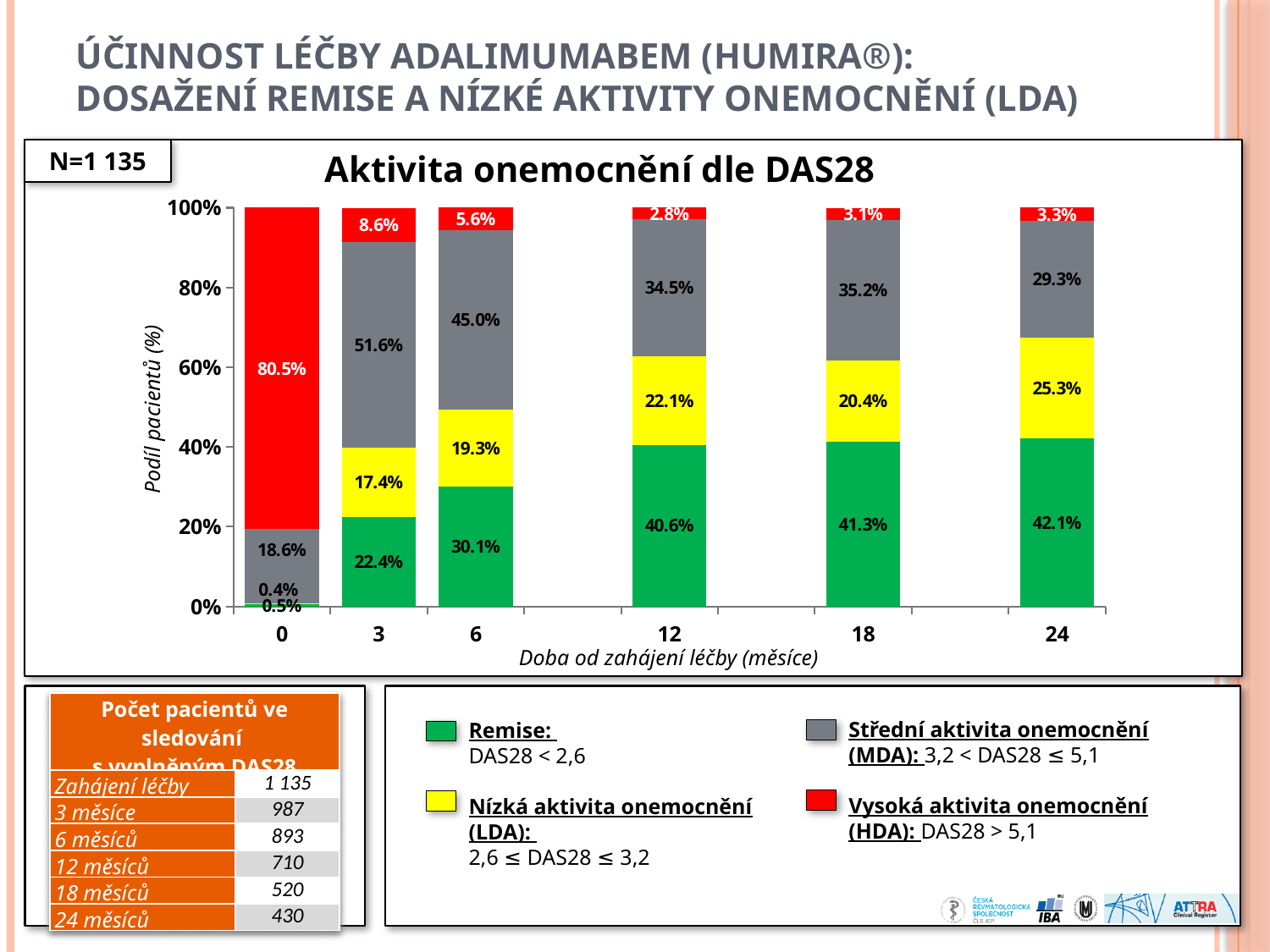
Which is larger: the moderate disease activity (grey) share at 3 months or at 6 months? 3 months What kind of chart is shown on the slide? stacked bar chart What is the share of patients with low disease activity (yellow) at 24 months? 25.3% What is the difference between the remission share at 24 months and at 3 months? 19.7% What is the share of patients with high disease activity (red) at month 0? 80.5% How many time points (categories) are shown on the x axis of the chart? 6 At which time point is the share of patients with high disease activity (red) the lowest? 12 What is the title of the chart? Aktivita onemocnění dle DAS28 How does the share of patients in remission (green) change from month 0 to month 24? It rises At which time point is the share of patients in remission (green) the highest? 24 What is the share of patients in remission (green) at 12 months? 40.6% How many categories of disease activity does the legend below the chart list? 4